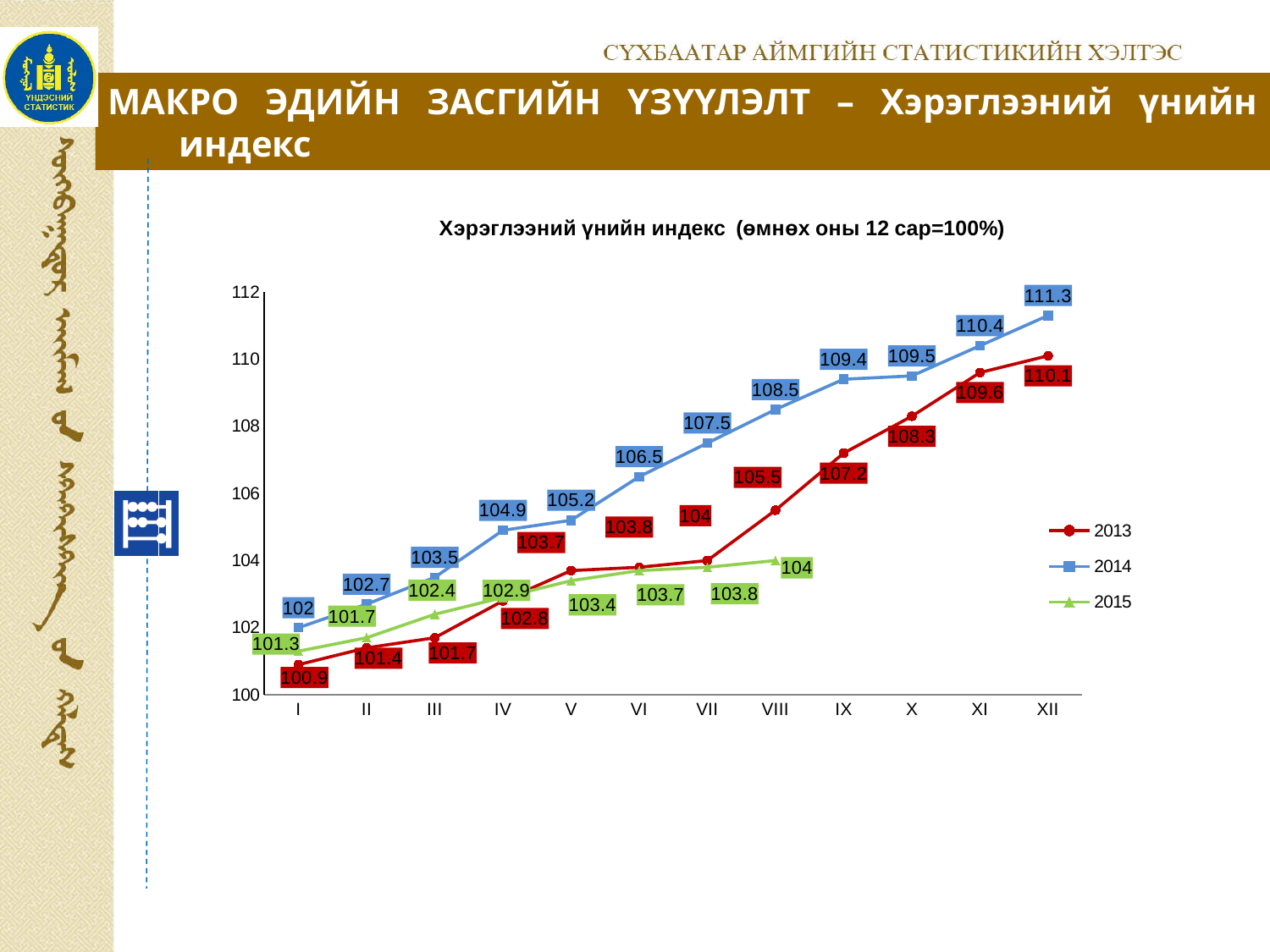
How many months are shown on the x axis? 12 Which series has the highest value in month XII? 2014 How many series does the legend list? 3 What is the 2014 value for month VI? 106.5 Which series has the lowest value in month I? 2013 What is the 2013 value for month I? 100.9 Does the 2014 series rise or fall from month I to month XII? Rise What is the 2015 value for month VIII? 104 What is the 2014 value for month XII? 111.3 What kind of chart is shown on the slide? Line chart Which is larger in month IV: the 2014 value or the 2015 value? 2014 What is the difference between the 2014 and 2013 values in month XII? 1.2